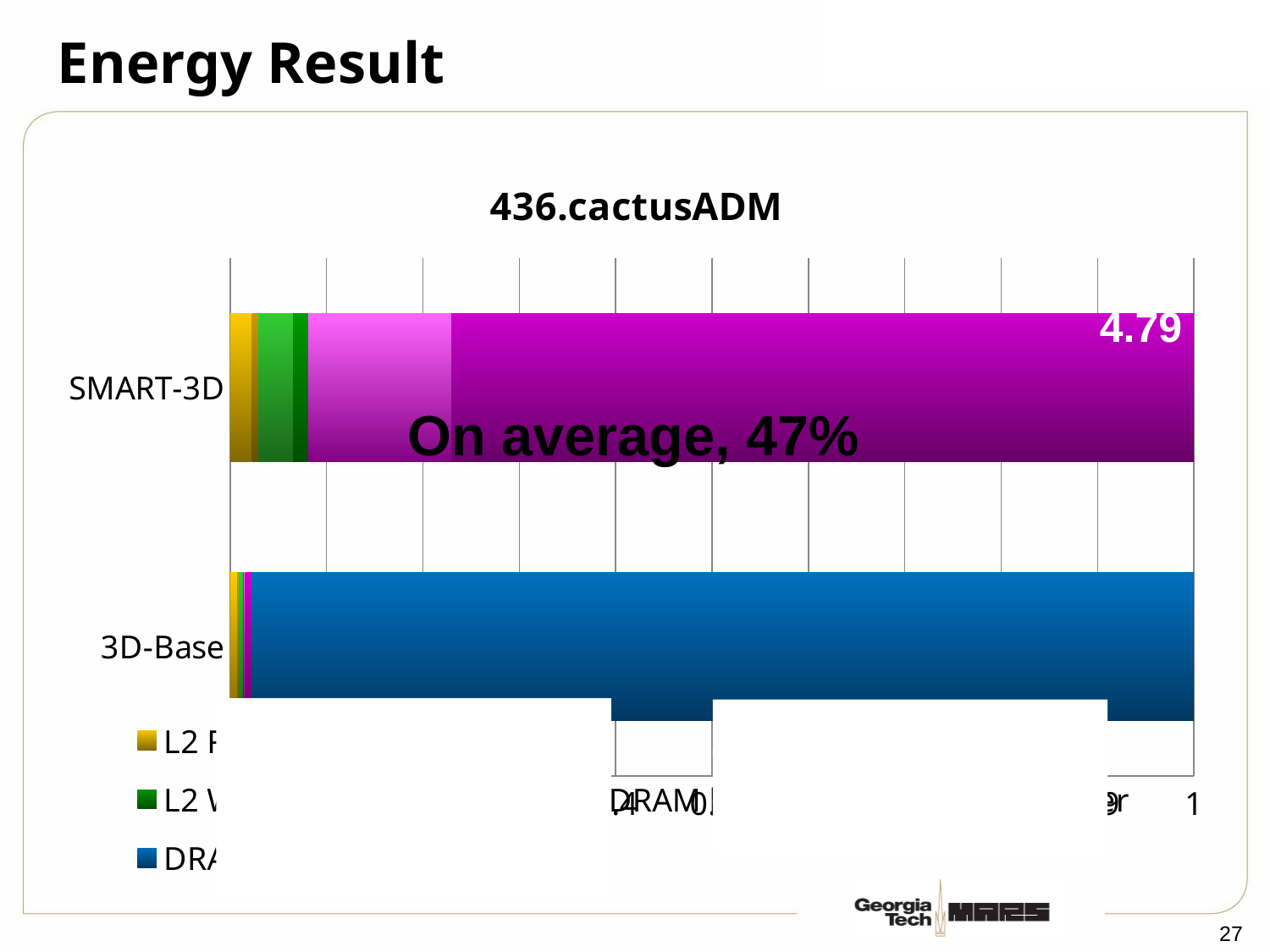
How many categories are plotted on the chart? 2 Which category is plotted below SMART-3D on the chart? 3D-Base What text is overlaid across the middle of the chart? On average, 47% What is the title of the chart? 436.cactusADM What value is printed as a data label on the SMART-3D bar? 4.79 What kind of chart is shown on the slide? bar chart